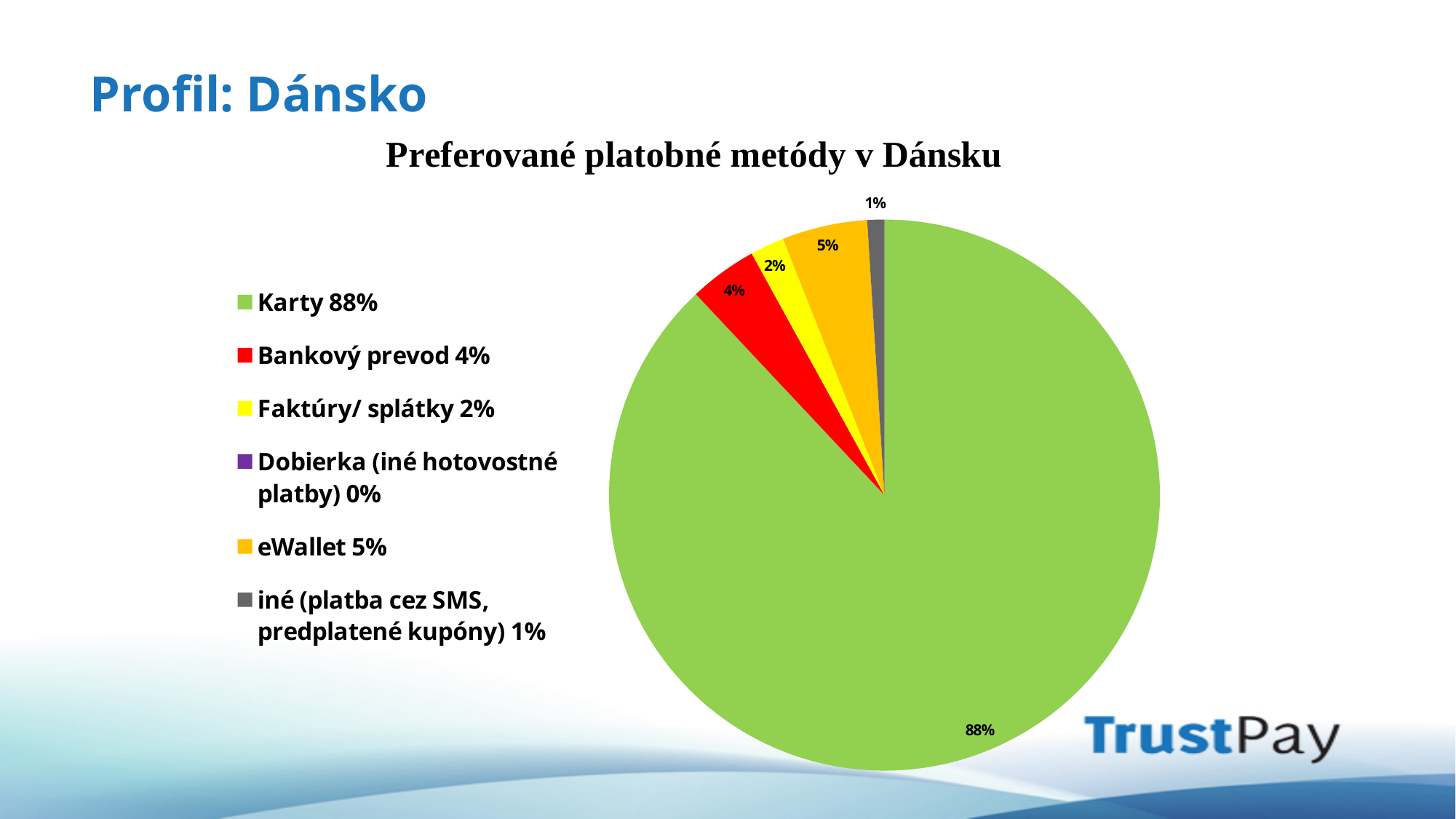
What is the value for eWallet? 5% Which is larger, the share for Bankový prevod or the share for eWallet? eWallet What is the value for Dobierka (iné hotovostné platby)? 0% What is the difference between the shares of Karty and eWallet? 83% What is the value for Bankový prevod? 4% What is the value for Faktúry/ splátky? 2% How many categories does the legend list? 6 What type of chart is shown on the slide? pie chart What is the title of the chart? Preferované platobné metódy v Dánsku What share of the pie does Karty have? 88% Which payment method has the smallest share? Dobierka (iné hotovostné platby) Which payment method has the largest share? Karty